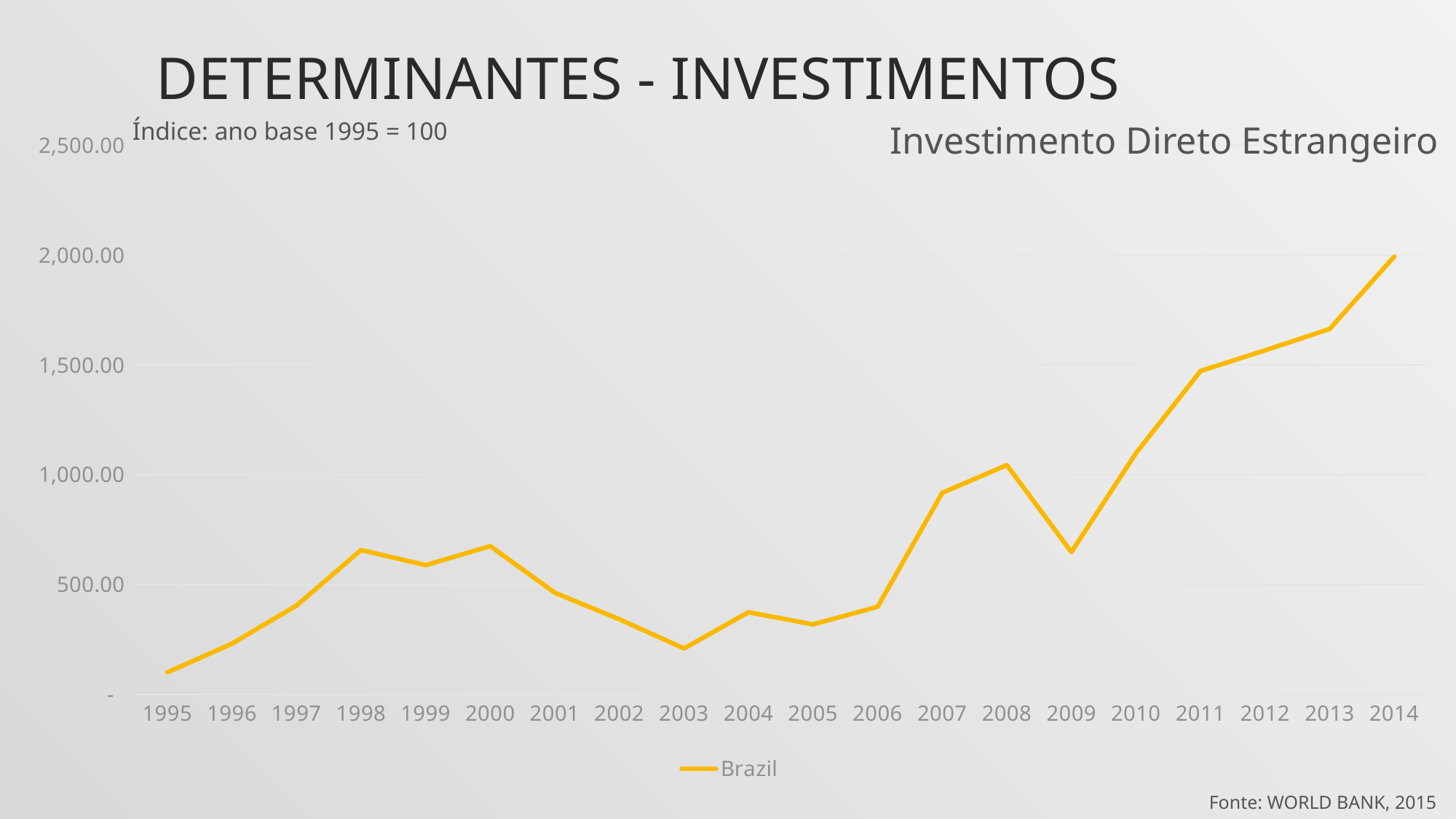
Is the value for Brazil in 2007 greater or less than 1,000.00? less How many series does the legend list? 1 In which year is the Brazil index at its highest? 2014 Is the value for Brazil in 2014 greater or less than 1,500.00? greater What kind of chart is shown on the slide? Line chart Which is larger, the value for Brazil in 2000 or in 2003? 2000 What is the title of the chart? Investimento Direto Estrangeiro How many years are plotted along the x axis? 20 Is the value for Brazil in 2003 greater or less than 500.00? less What is the index value for Brazil in the base year 1995? 100 Overall, does the Brazil index rise or fall from 1995 to 2014? Rise In which year is the Brazil index at its lowest? 1995